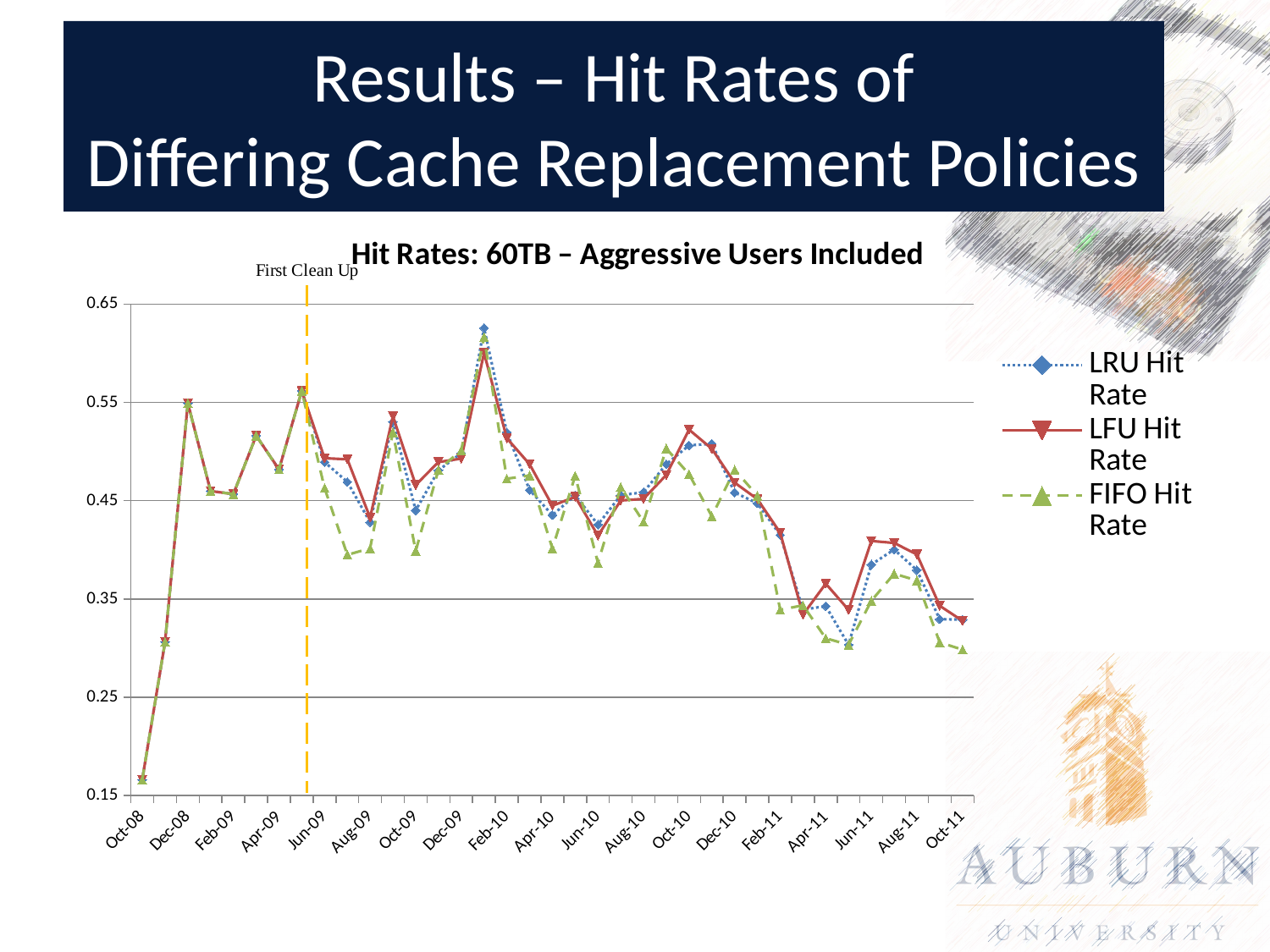
Is the LFU Hit Rate at Oct-10 greater or less than 0.45? greater Is the FIFO Hit Rate at Apr-11 greater or less than 0.35? less What kind of chart is shown on the slide? line chart Is the LRU Hit Rate at Oct-08 greater or less than 0.25? less What is the title of the chart? Hit Rates: 60TB – Aggressive Users Included At Aug-09, which is higher: the LFU Hit Rate or the FIFO Hit Rate? LFU Hit Rate At which x-axis label do all three series reach their lowest value? Oct-08 What label is attached to the dashed vertical line on the chart? First Clean Up How many month labels are shown along the x axis? 19 How many series does the legend list? 3 Do the hit rates rise or fall between Oct-08 and Dec-08? rise